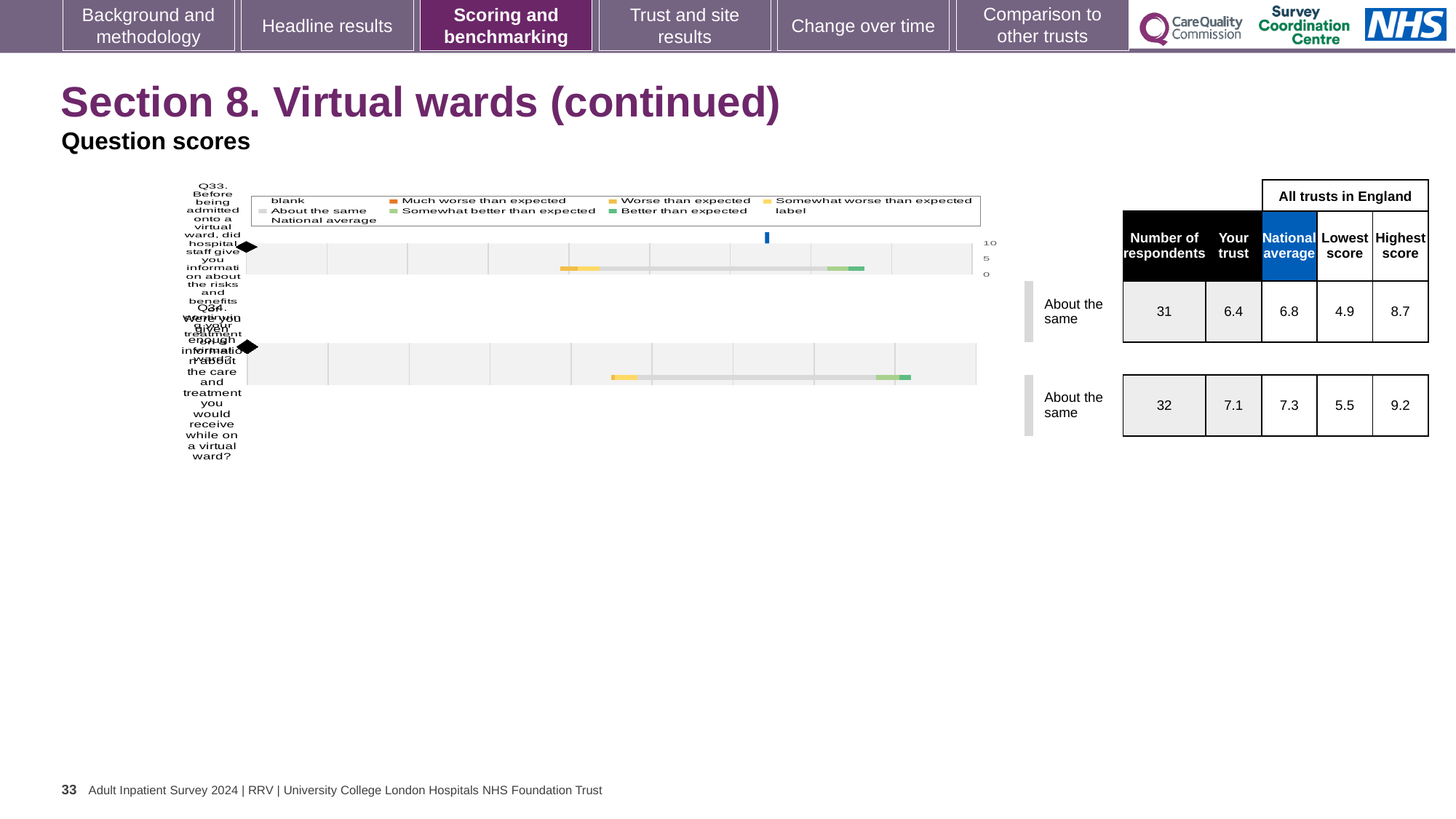
How many entries does the chart legend list? 9 How many respondents answered Q34? 32 What is the difference between the highest and lowest scores for Q34? 3.7 How many questions (categories) are plotted in the chart? 2 What is the lowest score across all trusts in England for Q34? 5.5 What is the national average score for Q34 (enough information about care and treatment on a virtual ward)? 7.3 What kind of chart is shown on the slide? bar chart What is the 'Your trust' score for Q33 (information about the risks and benefits of a virtual ward)? 6.4 Which question has the higher 'Your trust' score, Q33 or Q34? Q34 What is the difference between the national average and the 'Your trust' score for Q33? 0.4 What is the highest score across all trusts in England for Q33? 8.7 What benchmark category is shown for both Q33 and Q34? About the same